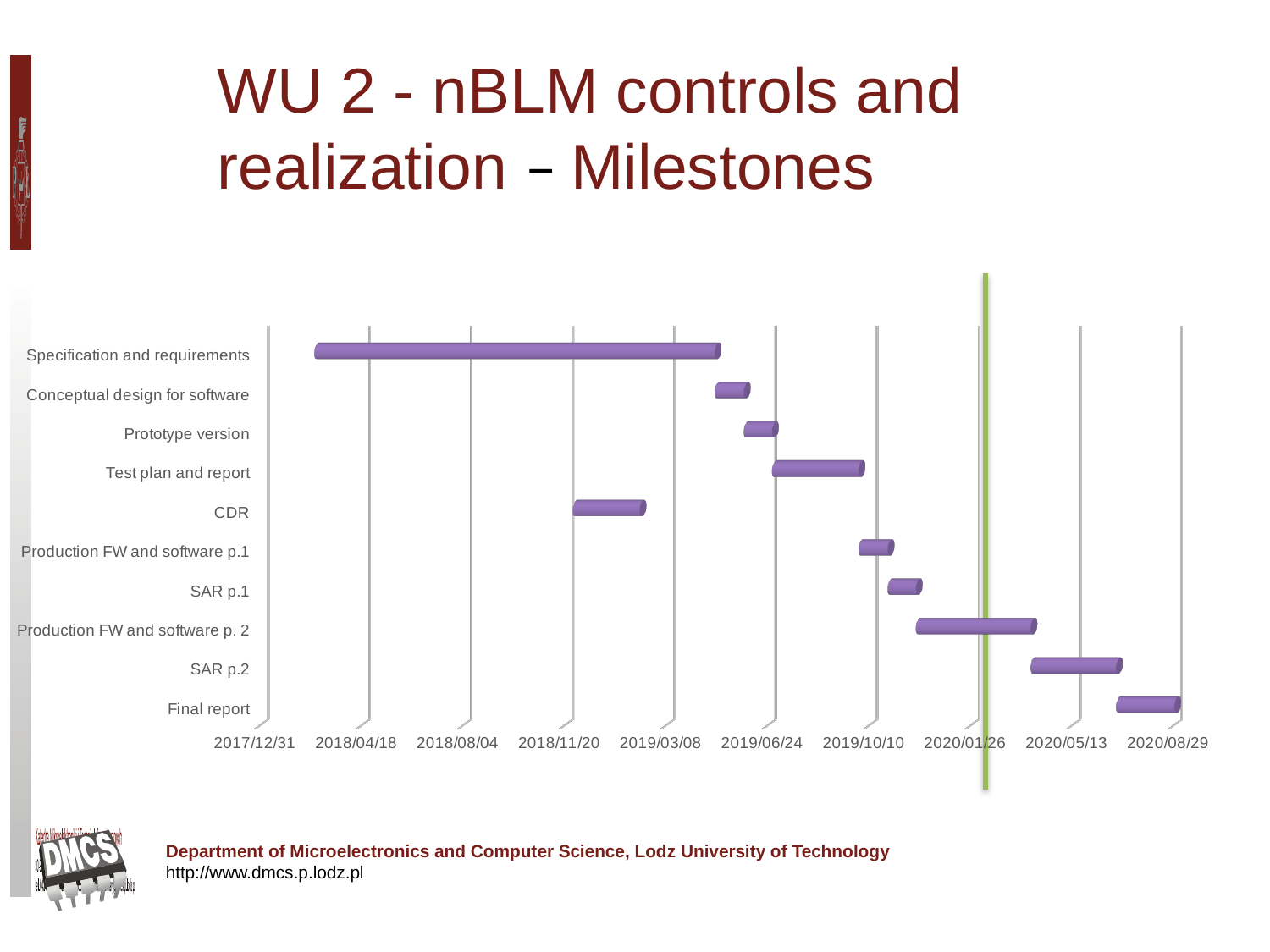
How many tasks are listed on the vertical axis of the chart? 10 What is the first date label shown on the horizontal axis? 2017/12/31 Does the bar for CDR end before or after 2019/03/08? before Which task has the longest bar in the chart? Specification and requirements Is the bar for Specification and requirements longer or shorter than the bar for CDR? longer Does the bar for Specification and requirements start before or after 2018/04/18? before Which task's bar is crossed by the green vertical line? Production FW and software p. 2 Which task's bar starts earliest on the time axis? Specification and requirements Which task's bar extends furthest to the right on the time axis? Final report Does the bar for Final report start before or after 2020/05/13? after Is the bar for Production FW and software p. 2 longer or shorter than the bar for SAR p.1? longer What kind of chart is shown on the slide? Bar chart (Gantt chart)